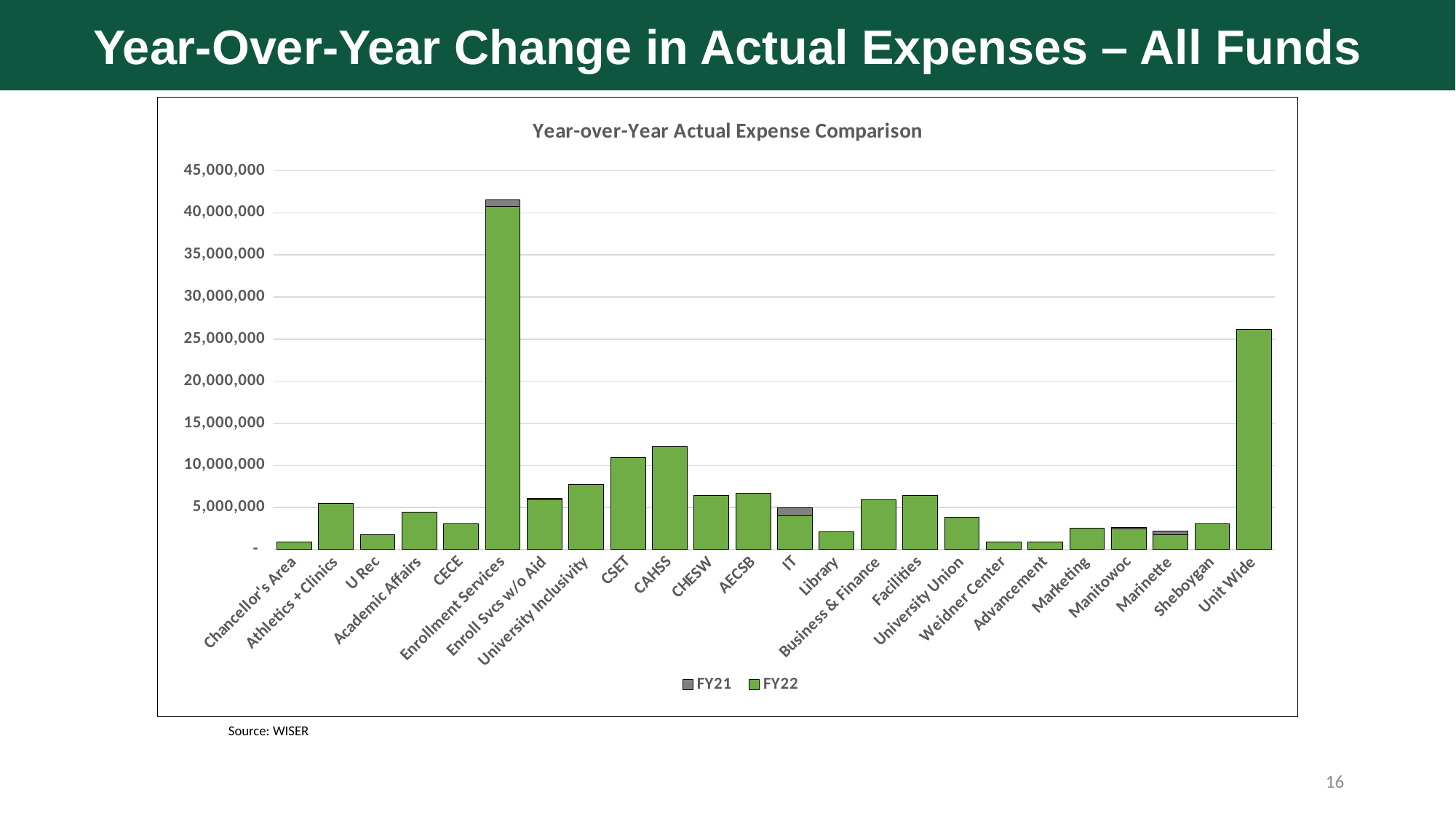
Which category has the highest expenses in the chart? Enrollment Services How many series does the legend list? 2 Which has the larger FY22 value, CSET or University Inclusivity? CSET Is the FY22 value for Library greater or less than 5,000,000? less Which has the larger FY22 value, Athletics + Clinics or U Rec? Athletics + Clinics Is the FY22 value for Enrollment Services greater or less than 40,000,000? greater What kind of chart is shown on the slide? bar chart What are the two series named in the legend? FY21 and FY22 Is the FY22 value for Unit Wide greater or less than 25,000,000? greater How many categories are shown along the x axis? 24 Which category has the second-tallest bar in the chart? Unit Wide